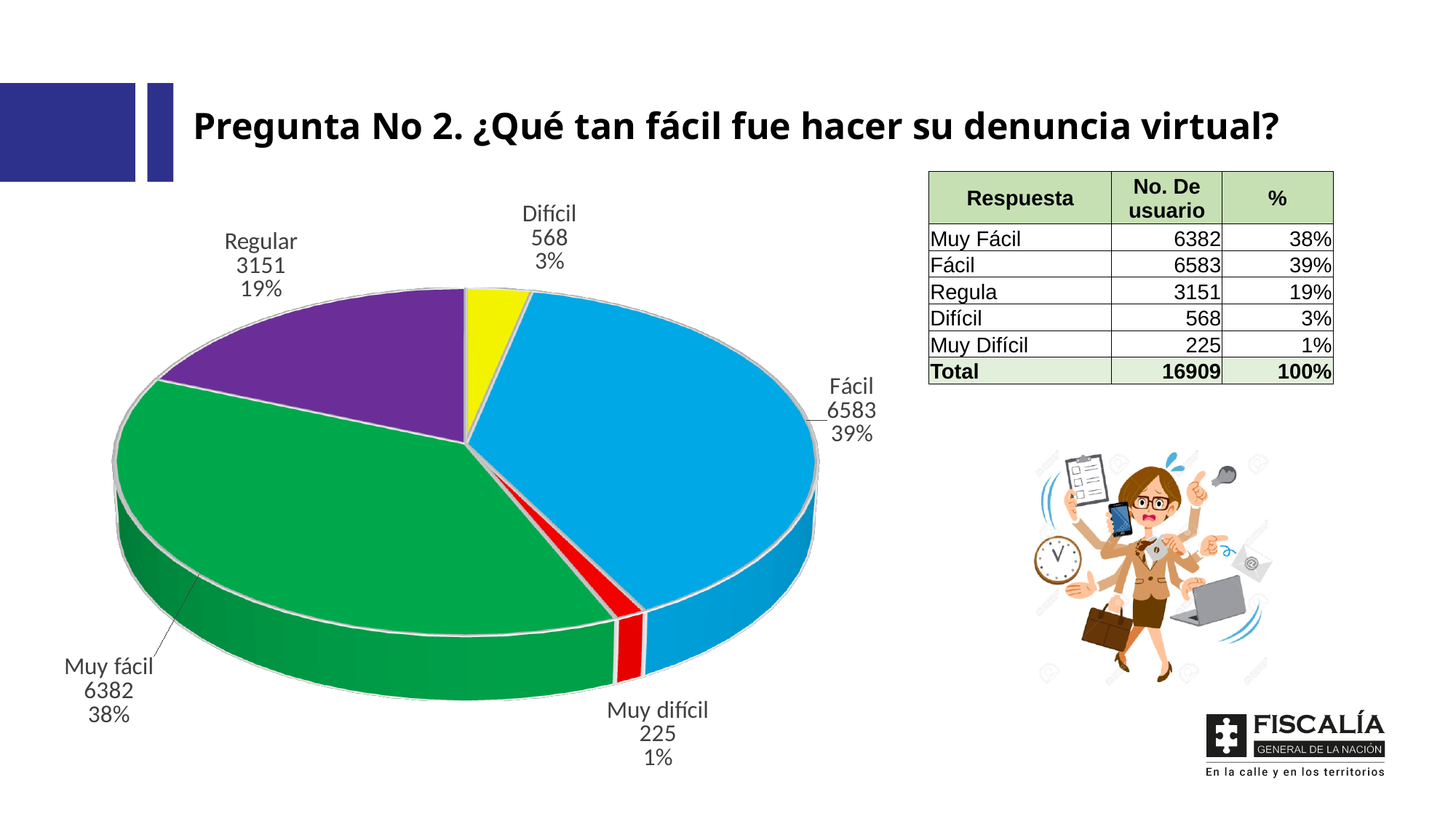
What is the number of users for the Muy difícil slice? 225 What is the difference in number of users between Regular and Difícil? 2583 What percentage share does the Difícil slice represent? 3% Which category has the smallest slice? Muy difícil What kind of chart is shown on the slide? Pie chart What is the number of users for the Fácil slice? 6583 What is the number of users for the Regular slice? 3151 Which has more users, Regular or Difícil? Regular How many slices does the pie chart have? 5 Which category has the largest slice? Fácil What percentage share does the Muy fácil slice represent? 38% What colour is the Regular slice? Purple